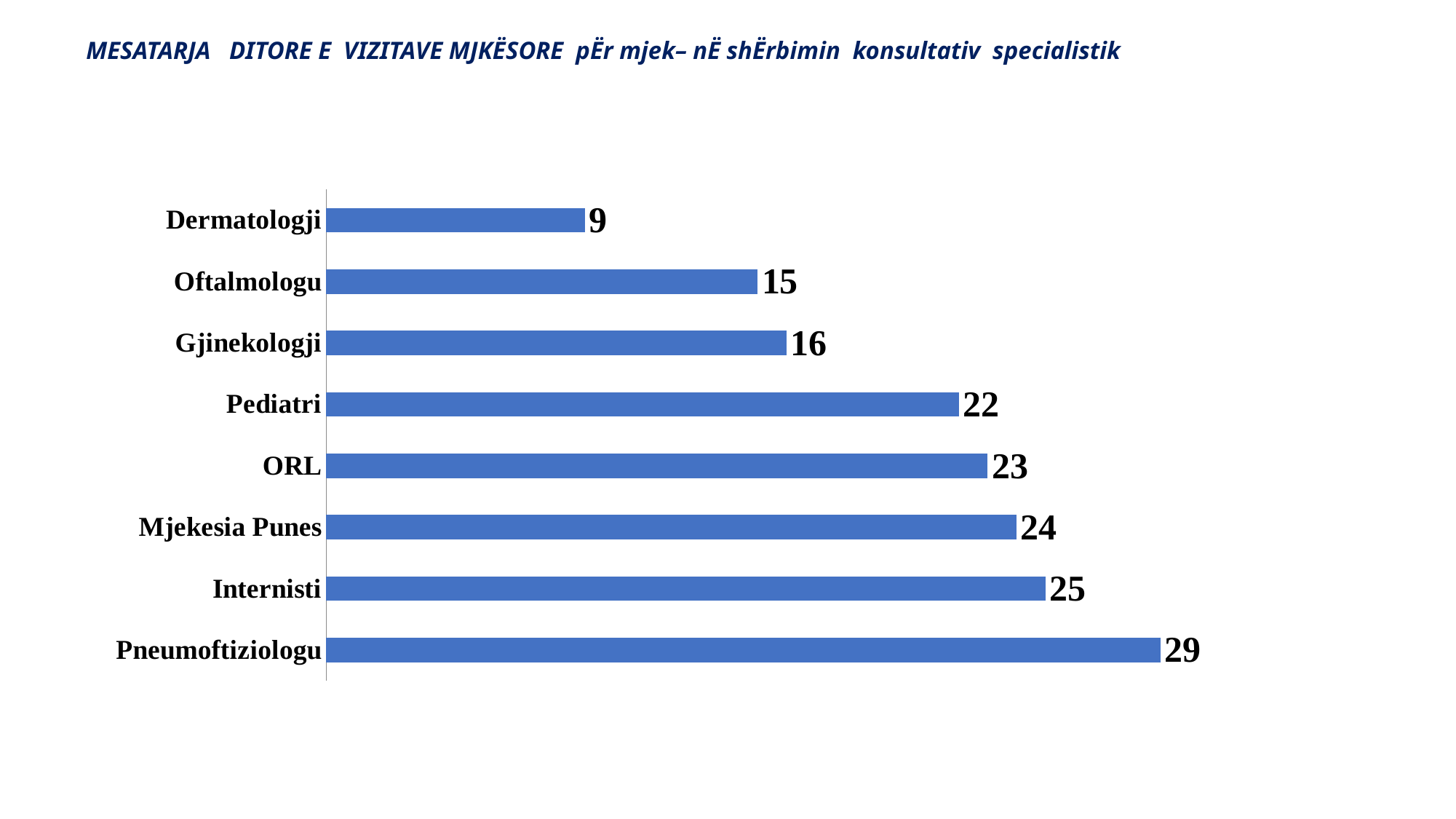
What kind of chart is shown on the slide? Bar chart What is the value for Pneumoftiziologu? 29 What is the value for Dermatologji? 9 What is the value for Gjinekologji? 16 Which is larger, the value for Mjekesia Punes or the value for Gjinekologji? Mjekesia Punes What is the value for ORL? 23 What colour are the bars in the chart? Blue Which category has the highest value? Pneumoftiziologu What is the difference between the values for Pediatri and Oftalmologu? 7 Which category has the lowest value? Dermatologji How many categories are shown in the chart? 8 What is the difference between the values for Pneumoftiziologu and Internisti? 4